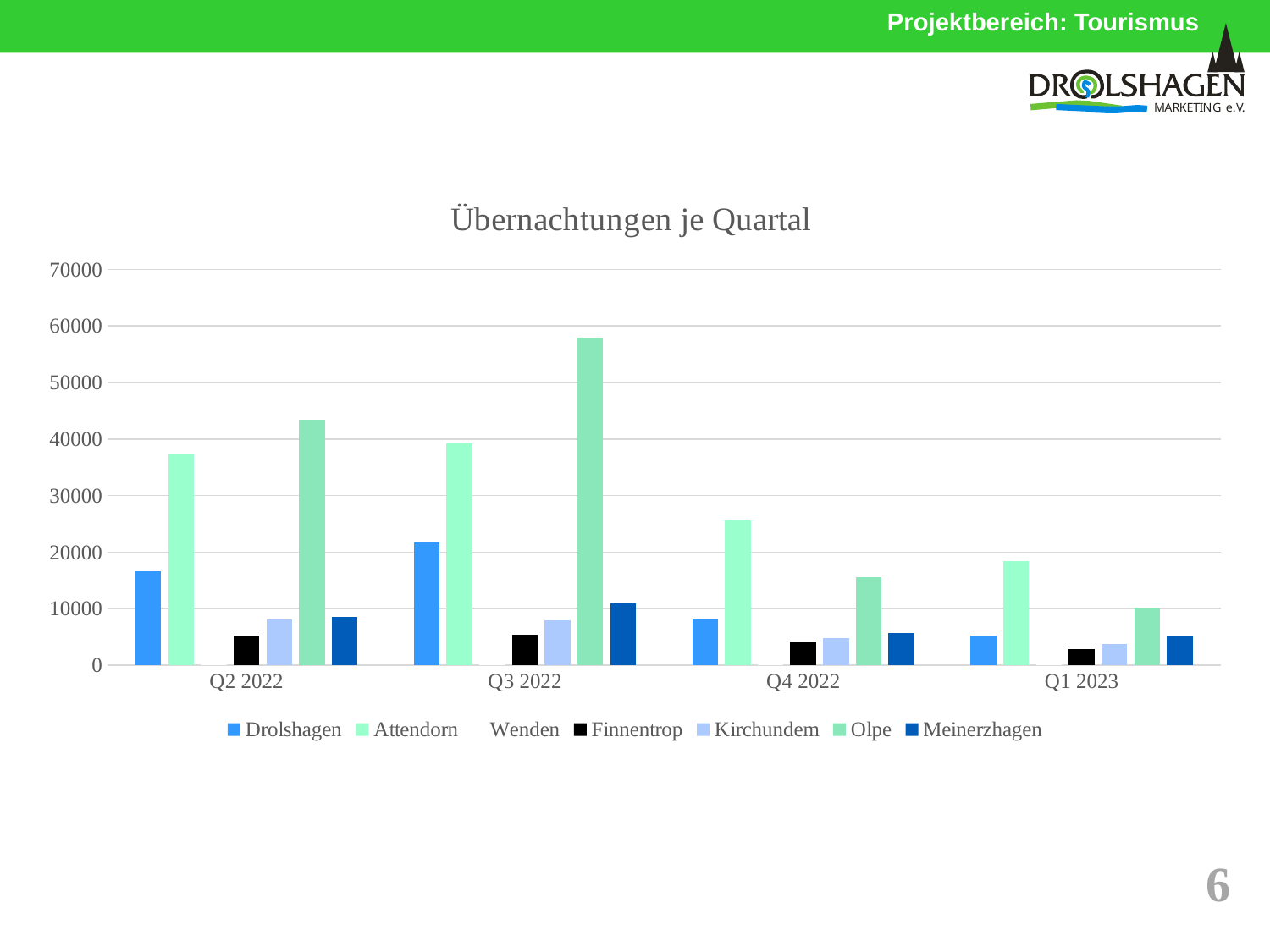
In Q2 2022, which is larger: Olpe or Attendorn? Olpe How many quarters are shown on the x axis? 4 Which series has the highest value in Q1 2023? Attendorn In Q4 2022, which is larger: Attendorn or Olpe? Attendorn How many series does the legend list? 7 Is the value for Attendorn in Q1 2023 greater or less than 20000? less What kind of chart is shown on the slide? bar chart Is the value for Drolshagen in Q3 2022 greater or less than 20000? greater In which quarter does Olpe have its highest value? Q3 2022 Do the values for Attendorn rise or fall from Q3 2022 to Q1 2023? fall Is the value for Olpe in Q3 2022 greater or less than 50000? greater What is the title of the chart? Übernachtungen je Quartal